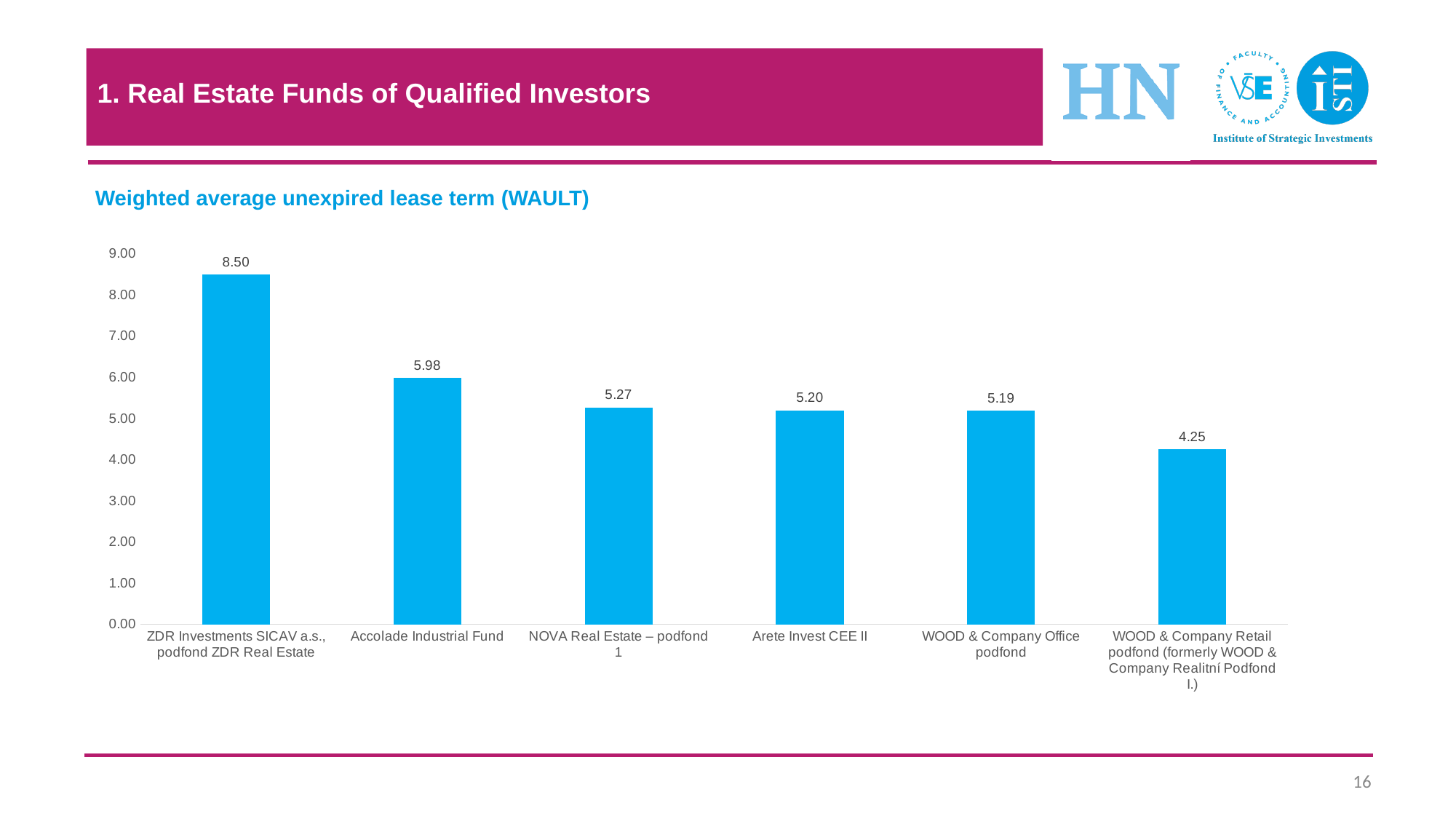
What is the WAULT value for Accolade Industrial Fund? 5.98 What is the difference between the WAULT of ZDR Investments SICAV a.s., podfond ZDR Real Estate and Accolade Industrial Fund? 2.52 What is the title of the chart? Weighted average unexpired lease term (WAULT) What type of chart is shown on the slide? Bar chart What is the WAULT value for Arete Invest CEE II? 5.20 Which fund has the lowest WAULT? WOOD & Company Retail podfond (formerly WOOD & Company Realitní Podfond I.) Which has a higher WAULT, Accolade Industrial Fund or NOVA Real Estate – podfond 1? Accolade Industrial Fund What is the difference between the values for NOVA Real Estate – podfond 1 and WOOD & Company Retail podfond? 1.02 What is the value shown for WOOD & Company Retail podfond? 4.25 How many funds are shown in the chart? 6 Which fund has the highest WAULT? ZDR Investments SICAV a.s., podfond ZDR Real Estate Is the value for WOOD & Company Office podfond greater or less than 6.00? less